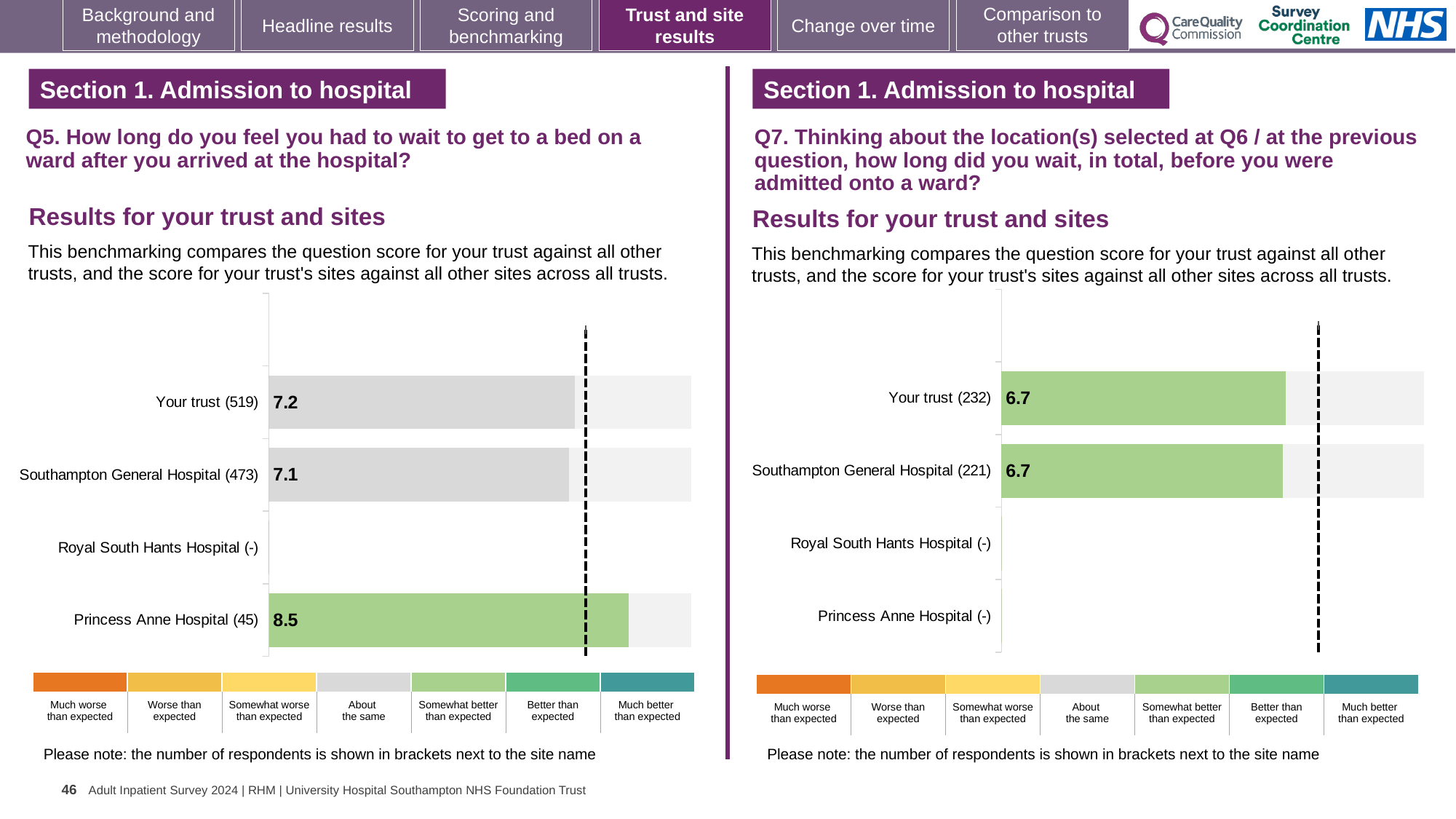
In the Q5 chart on the left, what is the score for Your trust (519)? 7.2 In the Q5 chart on the left, what is the score for Princess Anne Hospital (45)? 8.5 In the Q7 chart on the right, what is the score for Your trust (232)? 6.7 In the Q5 chart on the left, what is the score for Southampton General Hospital (473)? 7.1 In the Q5 chart on the left, which site has the highest score? Princess Anne Hospital (45) How many site rows (including Your trust) are listed in the Q5 chart on the left? 4 In the Q5 chart on the left, what is the difference between the scores for Princess Anne Hospital and Your trust? 1.3 In the Q5 chart on the left, which is larger: the score for Your trust or the score for Southampton General Hospital? Your trust In the Q7 chart on the right, what is the score for Southampton General Hospital (221)? 6.7 In the Q5 chart on the left, what colour is the bar for Princess Anne Hospital? Green In the Q7 chart on the right, what is the difference between the scores for Your trust and Southampton General Hospital? 0 What type of chart is used in the Q7 chart on the right? Bar chart